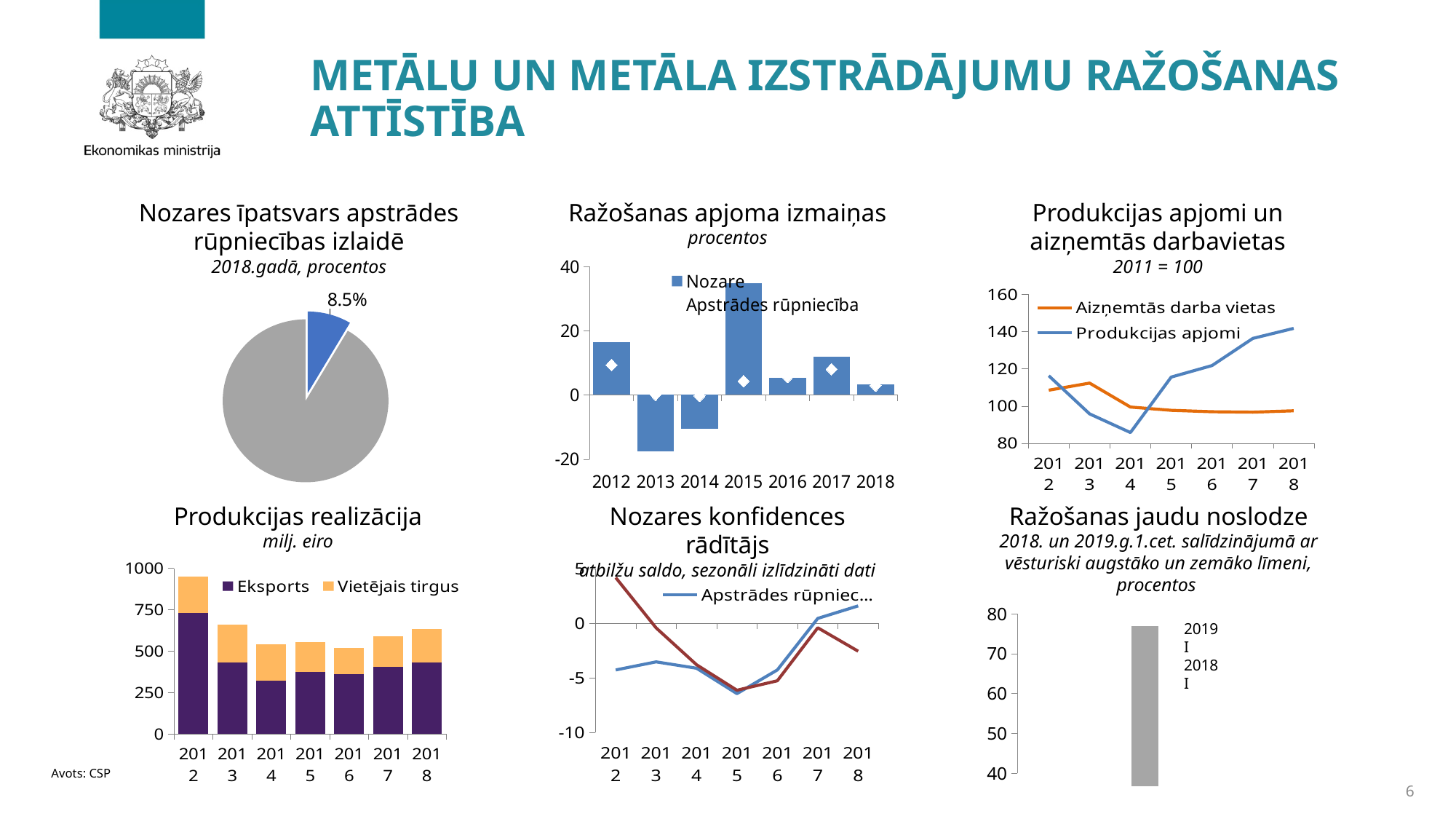
In the chart 'Produkcijas realizācija', is the Eksports value for 2012 greater or less than 500? greater In the chart 'Ražošanas apjoma izmaiņas', which year has the highest Nozare bar? 2015 What are the two legend entries in the chart 'Produkcijas realizācija'? Eksports and Vietējais tirgus In the chart 'Produkcijas realizācija', which year has the highest total bar? 2012 In the pie chart 'Nozares īpatsvars apstrādes rūpniecības izlaidē', what share is shown for the highlighted slice? 8.5% How many years are shown on the x axis of the chart 'Ražošanas apjoma izmaiņas'? 7 In the chart 'Produkcijas apjomi un aizņemtās darbavietas', does the Produkcijas apjomi line rise or fall from 2014 to 2018? rise In the chart 'Produkcijas apjomi un aizņemtās darbavietas', which series is higher in 2018, Produkcijas apjomi or Aizņemtās darba vietas? Produkcijas apjomi In the chart 'Ražošanas apjoma izmaiņas', which year has the lowest Nozare bar? 2013 How many series does the legend of the chart 'Produkcijas apjomi un aizņemtās darbavietas' list? 2 What kind of chart is 'Nozares īpatsvars apstrādes rūpniecības izlaidē'? pie chart In the chart 'Ražošanas apjoma izmaiņas', is the Nozare value for 2015 greater or less than 20? greater